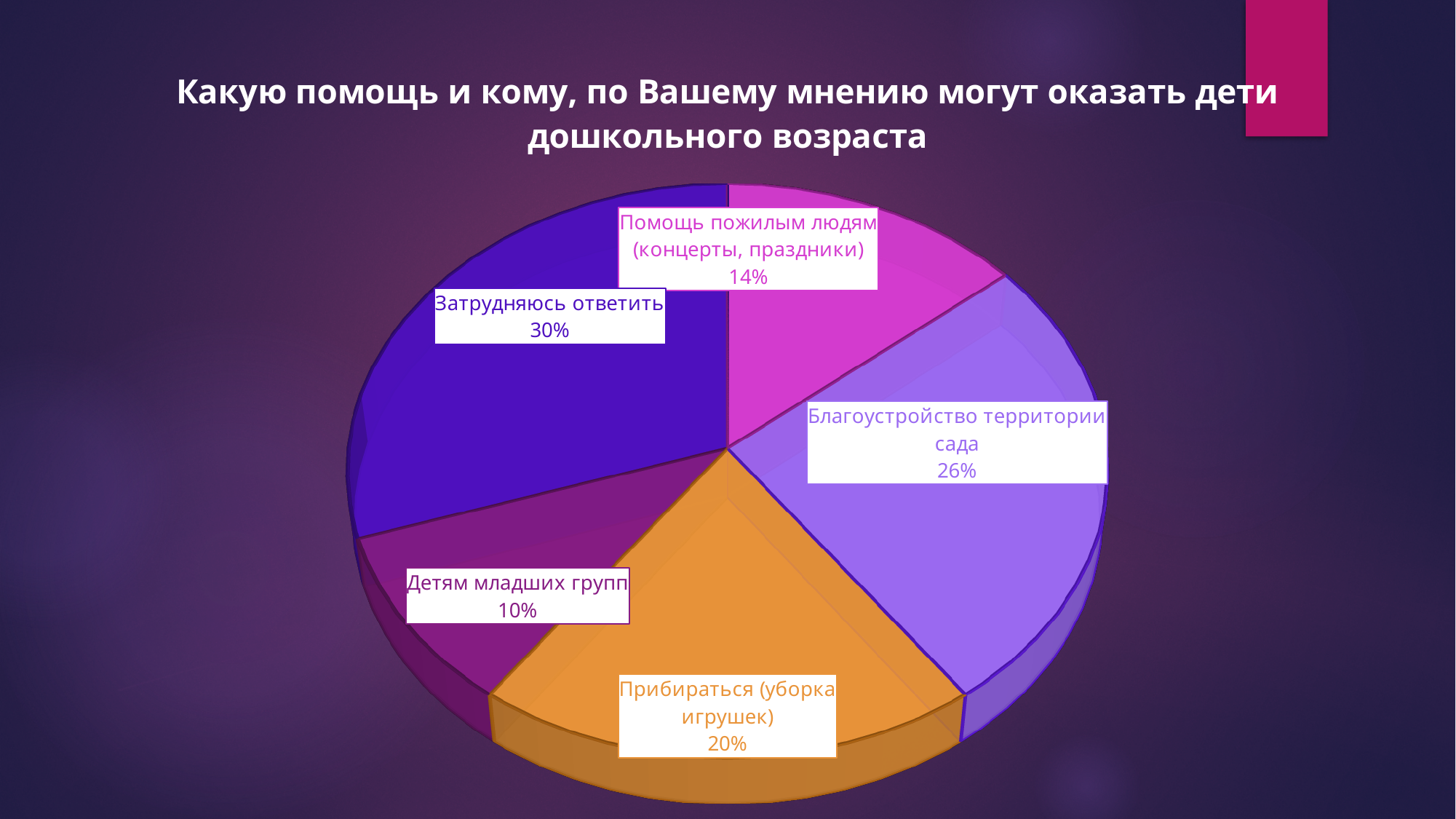
Which category has the largest slice of the pie? Затрудняюсь ответить What type of chart is shown on the slide? pie chart Which category has the smallest slice of the pie? Детям младших групп How many slices does the pie chart have? 5 What percentage is shown for "Помощь пожилым людям (концерты, праздники)"? 14% What is the difference in percentage points between "Затрудняюсь ответить" and "Детям младших групп"? 20 What share of the pie does "Затрудняюсь ответить" have? 30% What percentage is shown for "Благоустройство территории сада"? 26% What percentage is shown for "Прибираться (уборка игрушек)"? 20% What percentage is shown for "Детям младших групп"? 10% What is the title of the chart? Какую помощь и кому, по Вашему мнению могут оказать дети дошкольного возраста Which is larger: "Благоустройство территории сада" or "Прибираться (уборка игрушек)"? Благоустройство территории сада